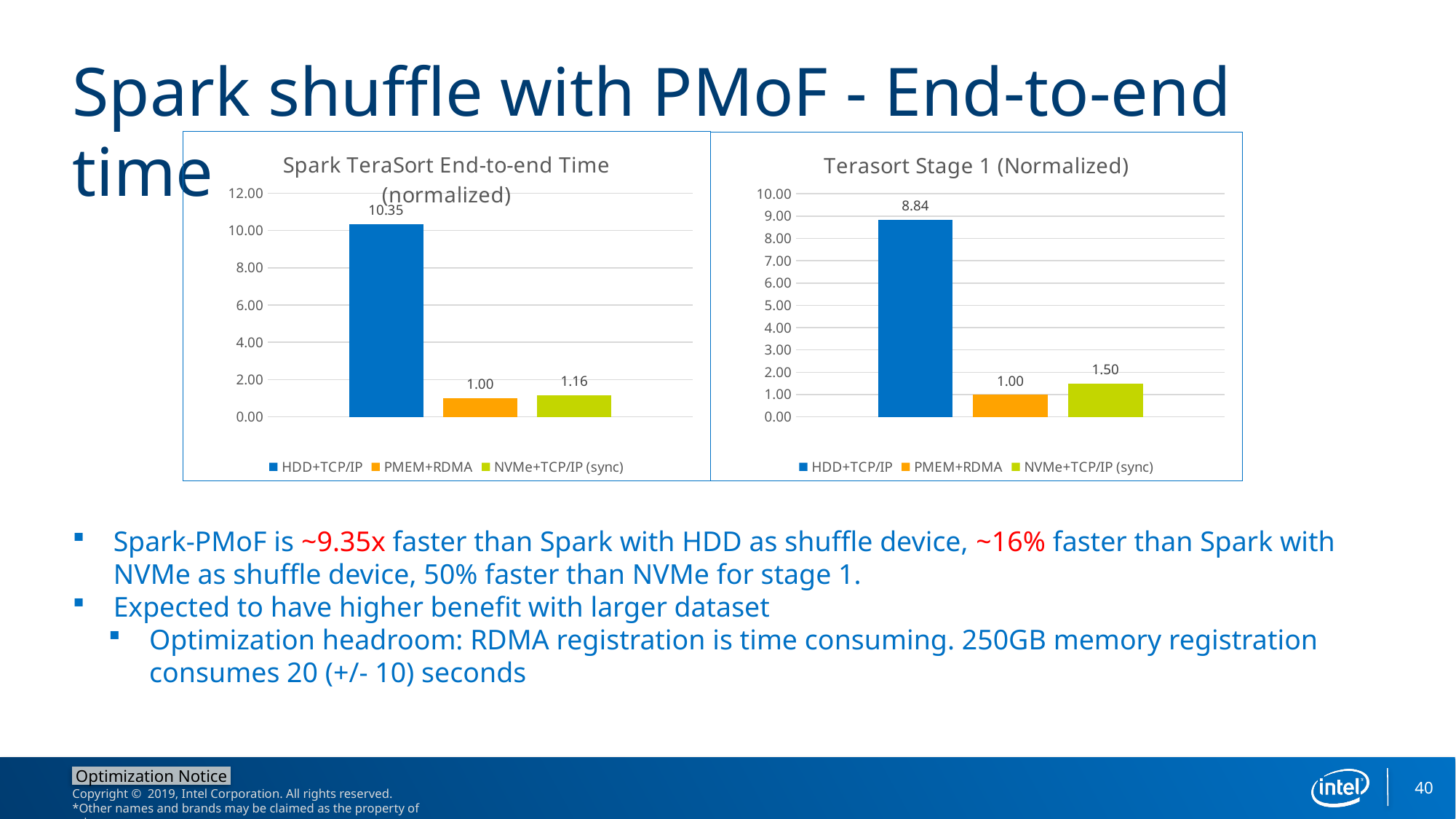
In the 'Spark TeraSort End-to-end Time (normalized)' chart, which series has the lowest value? PMEM+RDMA In the 'Spark TeraSort End-to-end Time (normalized)' chart, what is the value for HDD+TCP/IP? 10.35 In the 'Terasort Stage 1 (Normalized)' chart, what is the difference between the NVMe+TCP/IP (sync) value and the PMEM+RDMA value? 0.50 In the 'Terasort Stage 1 (Normalized)' chart, what is the value for NVMe+TCP/IP (sync)? 1.50 What kind of chart is the 'Terasort Stage 1 (Normalized)' chart? Bar chart In the 'Terasort Stage 1 (Normalized)' chart, which is larger: the value for PMEM+RDMA or the value for NVMe+TCP/IP (sync)? NVMe+TCP/IP (sync) In the 'Terasort Stage 1 (Normalized)' chart, which series has the highest value? HDD+TCP/IP In the 'Terasort Stage 1 (Normalized)' chart, what is the value for HDD+TCP/IP? 8.84 In the 'Spark TeraSort End-to-end Time (normalized)' chart, what is the value for NVMe+TCP/IP (sync)? 1.16 How many series does the legend of the 'Spark TeraSort End-to-end Time (normalized)' chart list? 3 In the 'Spark TeraSort End-to-end Time (normalized)' chart, what is the difference between the HDD+TCP/IP value and the PMEM+RDMA value? 9.35 In the 'Spark TeraSort End-to-end Time (normalized)' chart, what colour is the HDD+TCP/IP bar? Blue